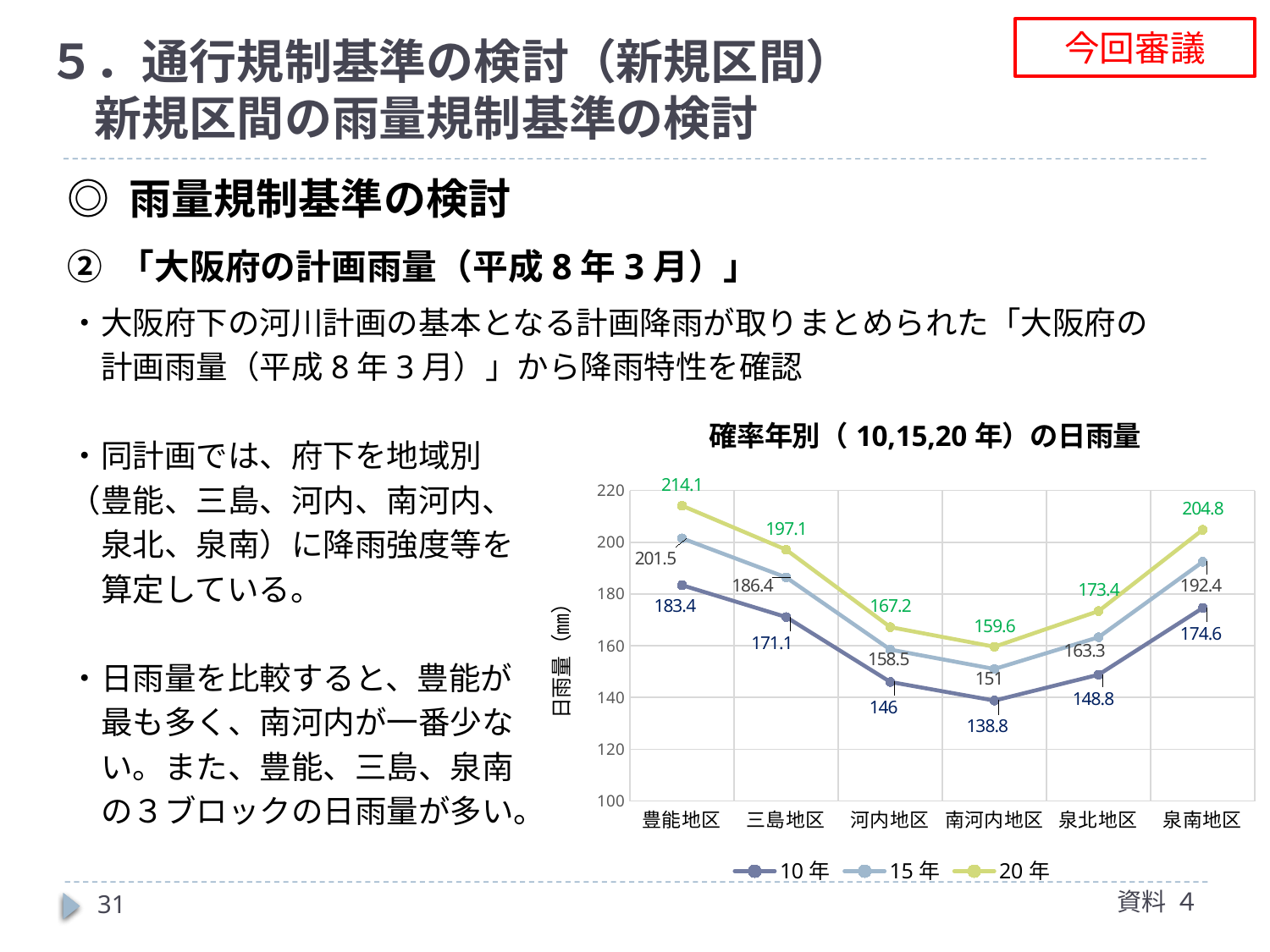
What is the label of the y axis of the chart? 日雨量（mm） What type of chart is shown on the slide? line chart What is the difference between the 20年 and 10年 values for 河内地区? 21.2 What is the value for 泉南地区 in the 15年 series? 192.4 Which district has the lowest value in the 20年 series? 南河内地区 What is the value for 豊能地区 in the 20年 series? 214.1 What is the value for 南河内地区 in the 10年 series? 138.8 Which is larger: the 15年 value for 三島地区 or the 15年 value for 泉北地区? 三島地区 Which district has the highest value in the 10年 series? 豊能地区 How many series does the legend list in the chart 確率年別（10,15,20年）の日雨量? 3 How many districts are plotted along the x axis of the chart? 6 Do the values in the 10年 series rise or fall from 豊能地区 to 南河内地区? fall